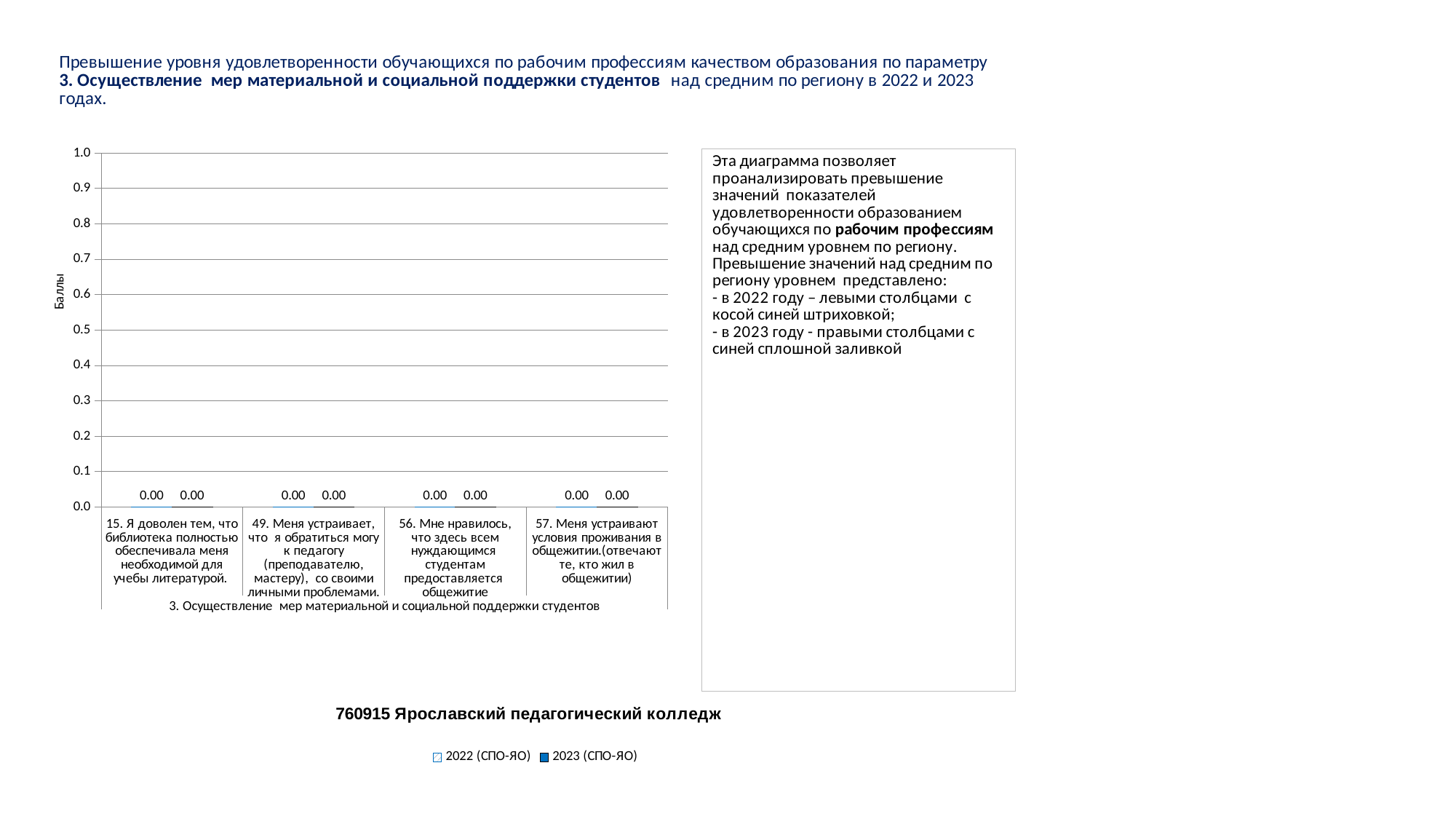
What are the two series names listed in the legend? 2022 (СПО-ЯО) and 2023 (СПО-ЯО) How many categories are shown on the x axis of the chart? 4 What is the label of the vertical axis? Баллы Is the value for 2023 (СПО-ЯО) for category 49 greater or less than 0.1? less What is the value for 2023 (СПО-ЯО) for category 57 (Меня устраивают условия проживания в общежитии)? 0.00 How many series does the legend list? 2 What is the value for 2022 (СПО-ЯО) for category 49 (Меня устраивает, что я обратиться могу к педагогу)? 0.00 What is the value for 2022 (СПО-ЯО) for category 15 (Я доволен тем, что библиотека полностью обеспечивала меня необходимой для учебы литературой)? 0.00 What is the difference between the 2022 (СПО-ЯО) and 2023 (СПО-ЯО) values for category 15? 0.00 What kind of chart is shown on the slide? bar chart What is the highest value shown on the vertical axis? 1.0 What is the value for 2023 (СПО-ЯО) for category 56 (Мне нравилось, что здесь всем нуждающимся студентам предоставляется общежитие)? 0.00